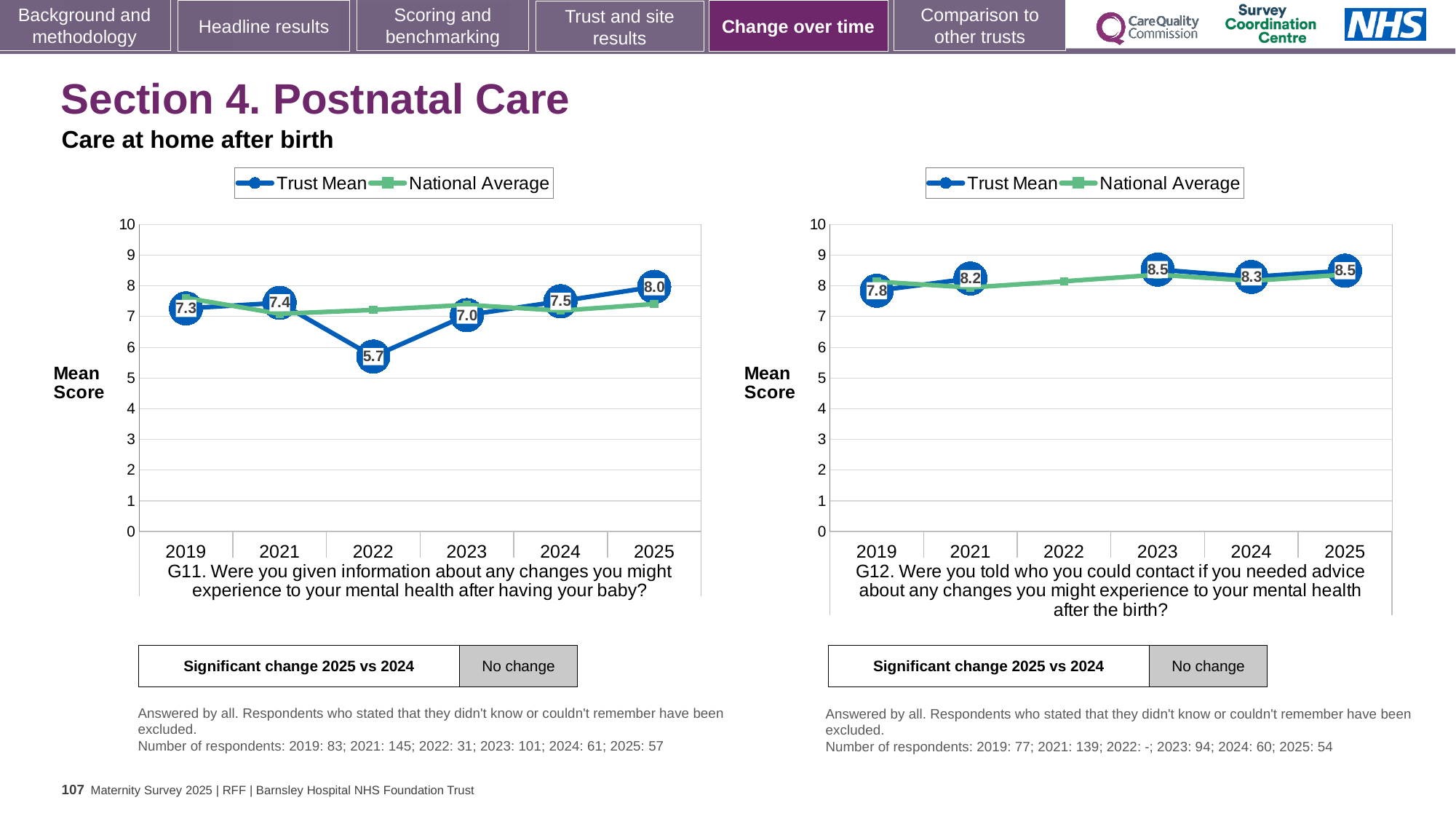
In the G11 chart, what is the Trust Mean for 2025? 8.0 What kind of chart is the G11 chart? line chart In the G12 chart, is the Trust Mean for 2021 larger or smaller than the Trust Mean for 2019? larger How many series does the legend of the G12 chart list? 2 In the G11 chart, what is the Trust Mean for 2022? 5.7 In the G12 chart, what is the Trust Mean for 2019? 7.8 In the G11 chart, which year has the lowest Trust Mean? 2022 In the G12 chart, what is the Trust Mean for 2024? 8.3 In the G11 chart, is the Trust Mean for 2022 greater or less than 6? less In the G12 chart, which year has the lowest Trust Mean? 2019 In the G11 chart, which year has the highest Trust Mean? 2025 In the G11 chart, what is the difference between the Trust Mean for 2025 and the Trust Mean for 2022? 2.3